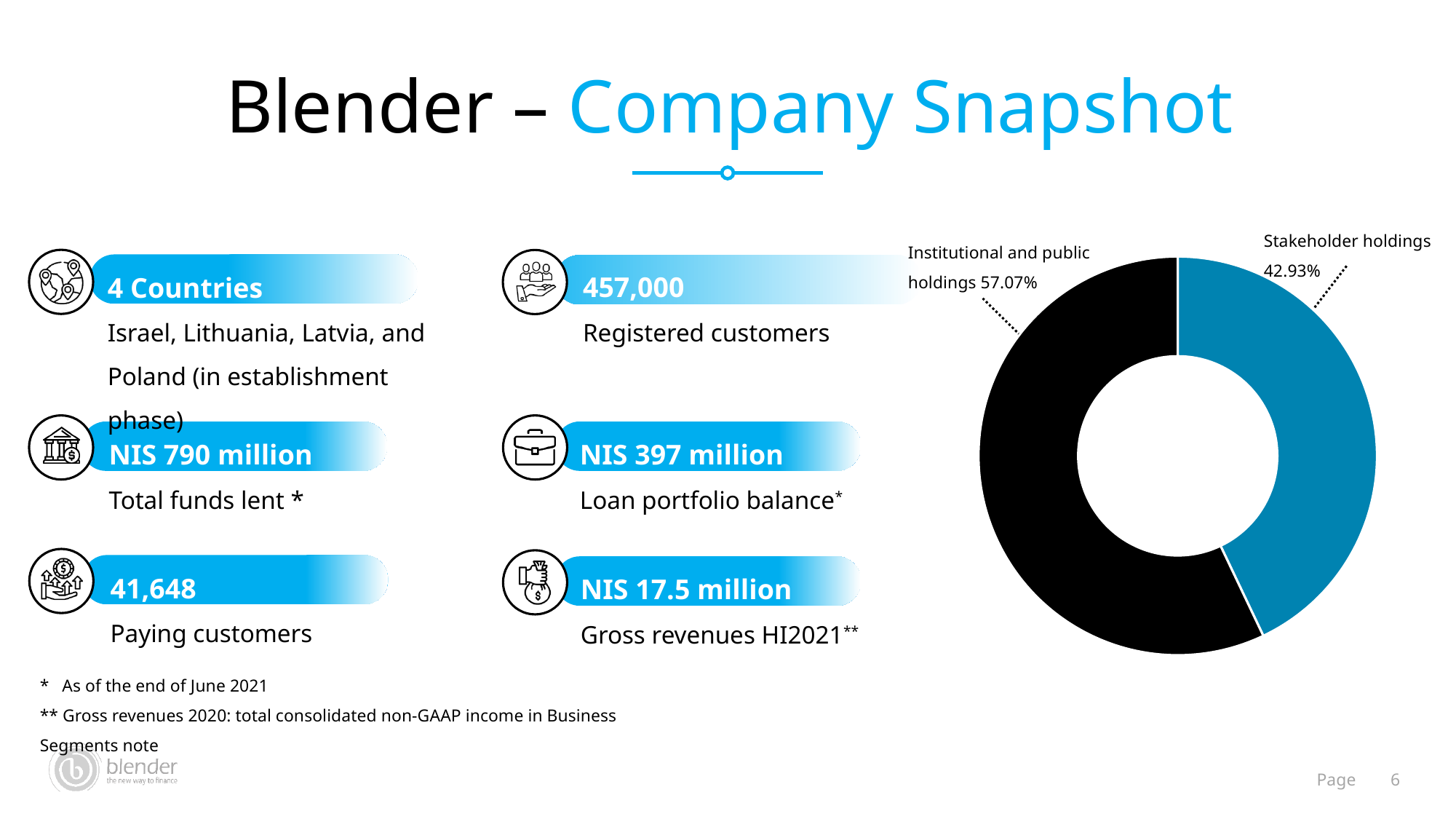
What colour is the institutional and public holdings slice? Black Which slice of the doughnut chart is the largest? Institutional and public holdings Which is larger: stakeholder holdings or institutional and public holdings? Institutional and public holdings What share of holdings is held by institutional and public holders? 57.07% What is the difference in percentage points between institutional and public holdings and stakeholder holdings? 14.14 Which slice of the doughnut chart is the smallest? Stakeholder holdings What share of holdings is held by stakeholders? 42.93% How many slices does the doughnut chart have? 2 What colour is the stakeholder holdings slice? Blue What kind of chart is shown on the slide? Doughnut chart Is the share for stakeholder holdings greater or less than 50%? less